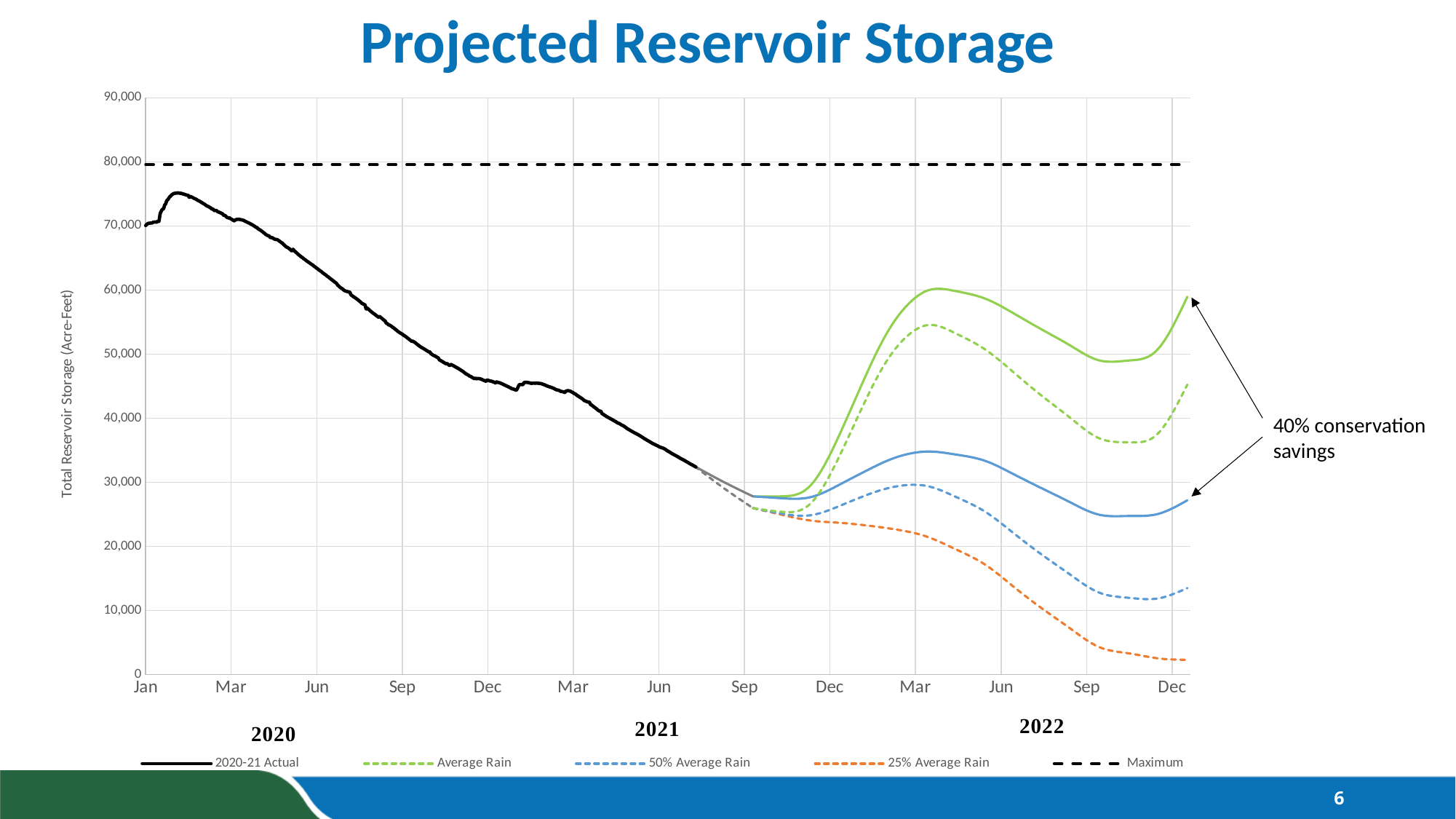
Is the Average Rain projection in Mar 2022 greater or less than 50,000? greater How many years are labeled along the x axis? 3 Is the Maximum line greater or less than 70,000 acre-feet? greater How many series does the legend list? 5 In Mar 2022, which is larger: the Average Rain projection or the 25% Average Rain projection? Average Rain What is the title of the chart? Projected Reservoir Storage Is the peak of the 2020-21 Actual line in early 2020 greater or less than 80,000? less What kind of chart is shown on the slide? Line chart What is the label of the vertical axis? Total Reservoir Storage (Acre-Feet) Does the 2020-21 Actual line rise or fall from Mar 2020 to Jun 2021? Fall Which rain scenario ends lowest in Dec 2022? 25% Average Rain